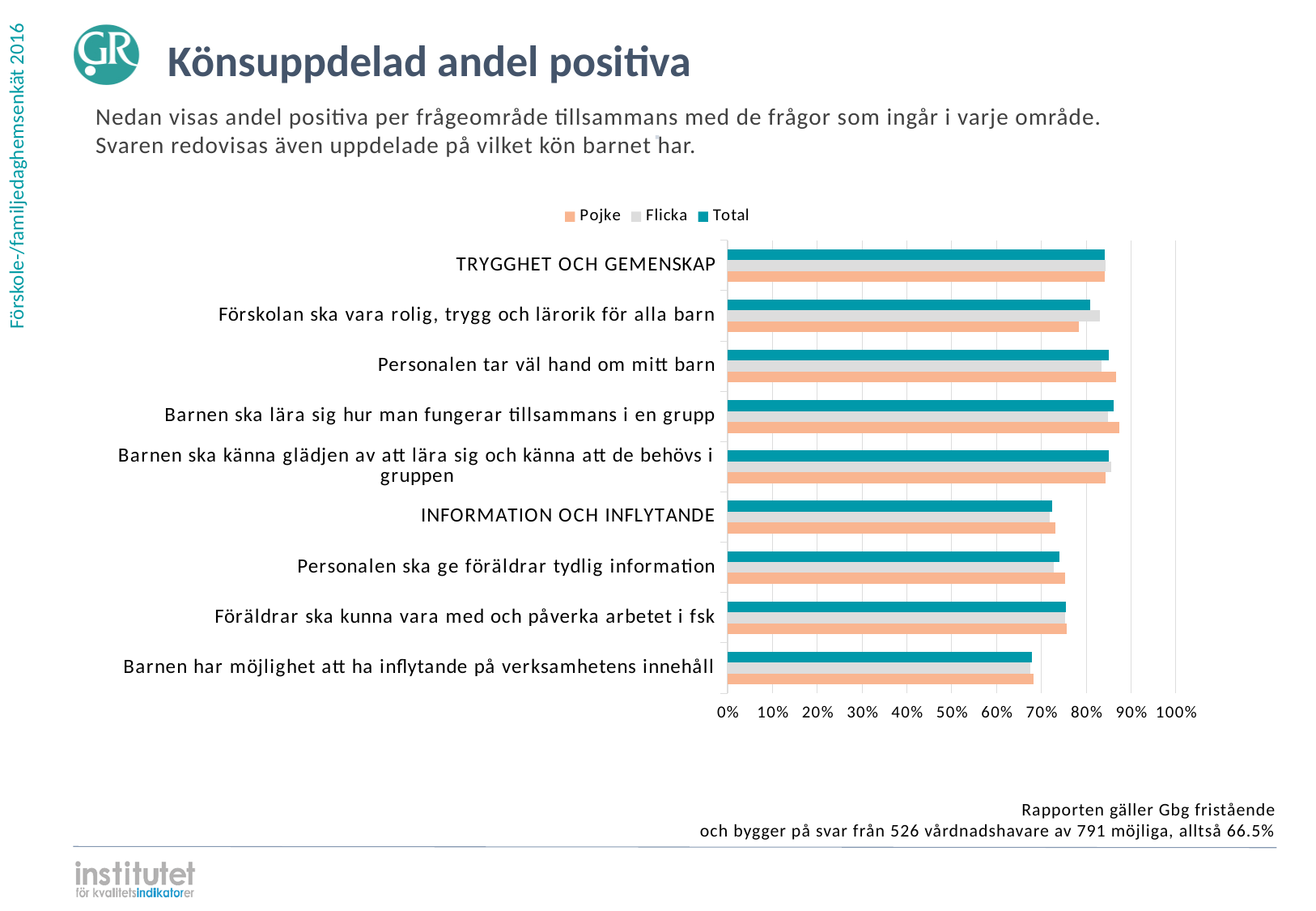
Is the Pojke value for "Personalen ska ge föräldrar tydlig information" greater or less than 80%? less Is the Total value for "TRYGGHET OCH GEMENSKAP" greater or less than 80%? greater What kind of chart is shown on the slide? bar chart Is the Total value for "INFORMATION OCH INFLYTANDE" greater or less than 80%? less Which category has the lowest Total value? Barnen har möjlighet att ha inflytande på verksamhetens innehåll How many series does the legend list? 3 Which series is shown in orange in the legend? Pojke Which series is shown in teal in the legend? Total Which has the larger Total value, "TRYGGHET OCH GEMENSKAP" or "INFORMATION OCH INFLYTANDE"? TRYGGHET OCH GEMENSKAP How many categories are plotted on the chart? 9 For "Förskolan ska vara rolig, trygg och lärorik för alla barn", which is larger, the Pojke value or the Flicka value? Flicka